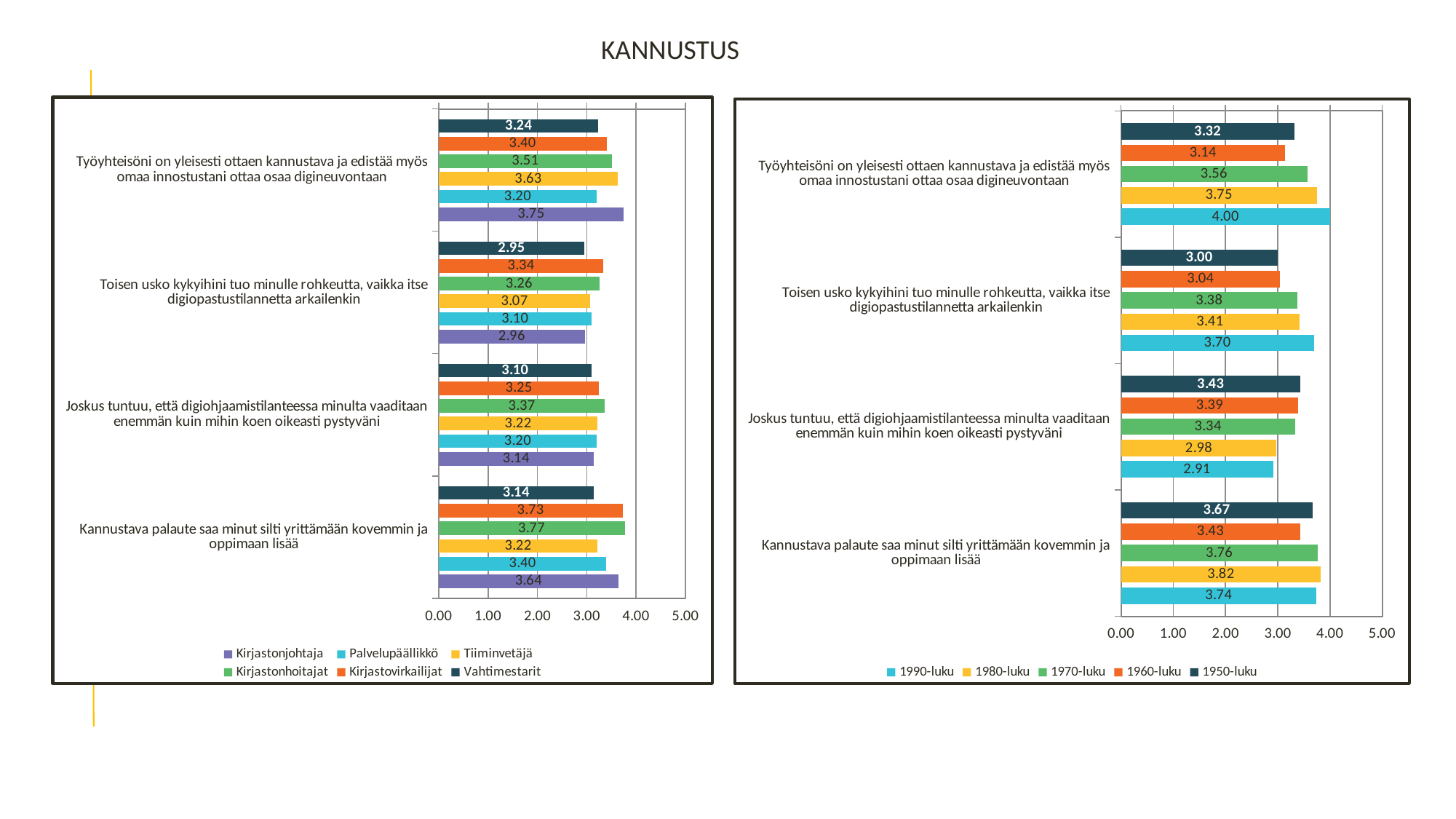
In the right chart, which decade group has the lowest value on the statement "Joskus tuntuu, että digiohjaamistilanteessa minulta vaaditaan enemmän kuin mihin koen oikeasti pystyväni"? 1990-luku In the left chart, which group has the highest value on the statement "Kannustava palaute saa minut silti yrittämään kovemmin ja oppimaan lisää"? Kirjastonhoitajat In the right chart, what is the value for 1990-luku on the statement "Työyhteisöni on yleisesti ottaen kannustava ja edistää myös omaa innostustani ottaa osaa digineuvontaan"? 4.00 In the left chart, what is the value for Vahtimestarit on the statement "Toisen usko kykyihini tuo minulle rohkeutta, vaikka itse digiopastustilannetta arkailenkin"? 2.95 What kind of chart is the right chart? Bar chart In the right chart, what is the difference between the 1990-luku and 1950-luku values on the statement "Toisen usko kykyihini tuo minulle rohkeutta, vaikka itse digiopastustilannetta arkailenkin"? 0.70 In the right chart, is the value for 1980-luku on the statement "Joskus tuntuu, että digiohjaamistilanteessa minulta vaaditaan enemmän kuin mihin koen oikeasti pystyväni" greater or less than 3.00? less In the left chart, what is the value for Kirjastonjohtaja on the statement "Työyhteisöni on yleisesti ottaen kannustava ja edistää myös omaa innostustani ottaa osaa digineuvontaan"? 3.75 In the left chart, which is larger on the statement "Kannustava palaute saa minut silti yrittämään kovemmin ja oppimaan lisää": the value for Kirjastovirkailijat or the value for Palvelupäällikkö? Kirjastovirkailijat How many series does the legend of the right chart list? 5 How many series does the legend of the left chart list? 6 What is the title of the slide? KANNUSTUS